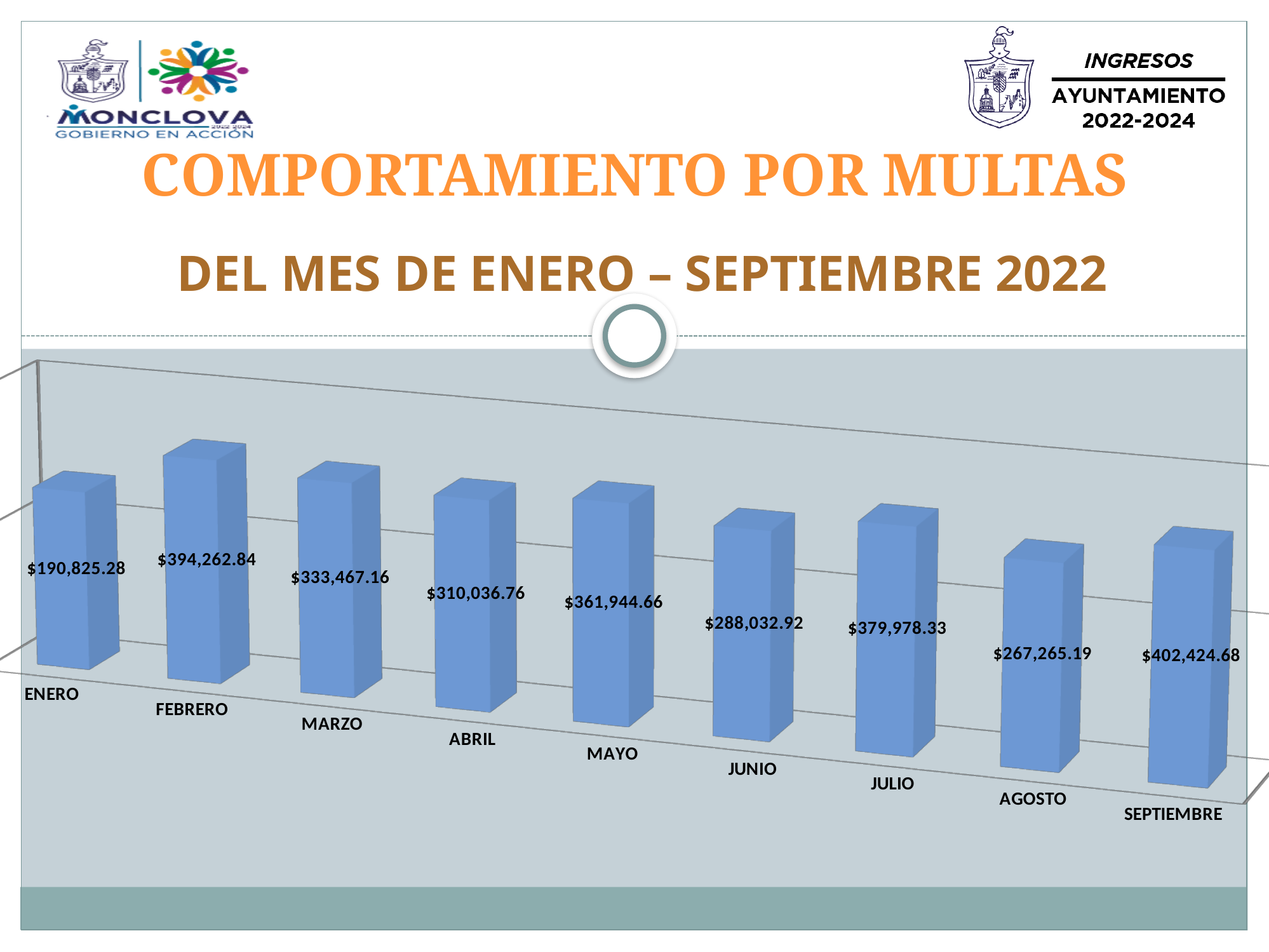
What is the difference between the values for FEBRERO and ENERO? $203,437.56 What kind of chart is shown on the slide? Bar chart How many months are shown in the chart? 9 Which is larger, the value for MAYO or the value for MARZO? MAYO What is the value for SEPTIEMBRE? $402,424.68 What is the value for ABRIL? $310,036.76 Which month has the highest value? SEPTIEMBRE What is the difference between the values for SEPTIEMBRE and AGOSTO? $135,159.49 What is the value for FEBRERO? $394,262.84 Which month has the lowest value? ENERO What is the value for JUNIO? $288,032.92 Does the value rise or fall from JULIO to AGOSTO? Fall